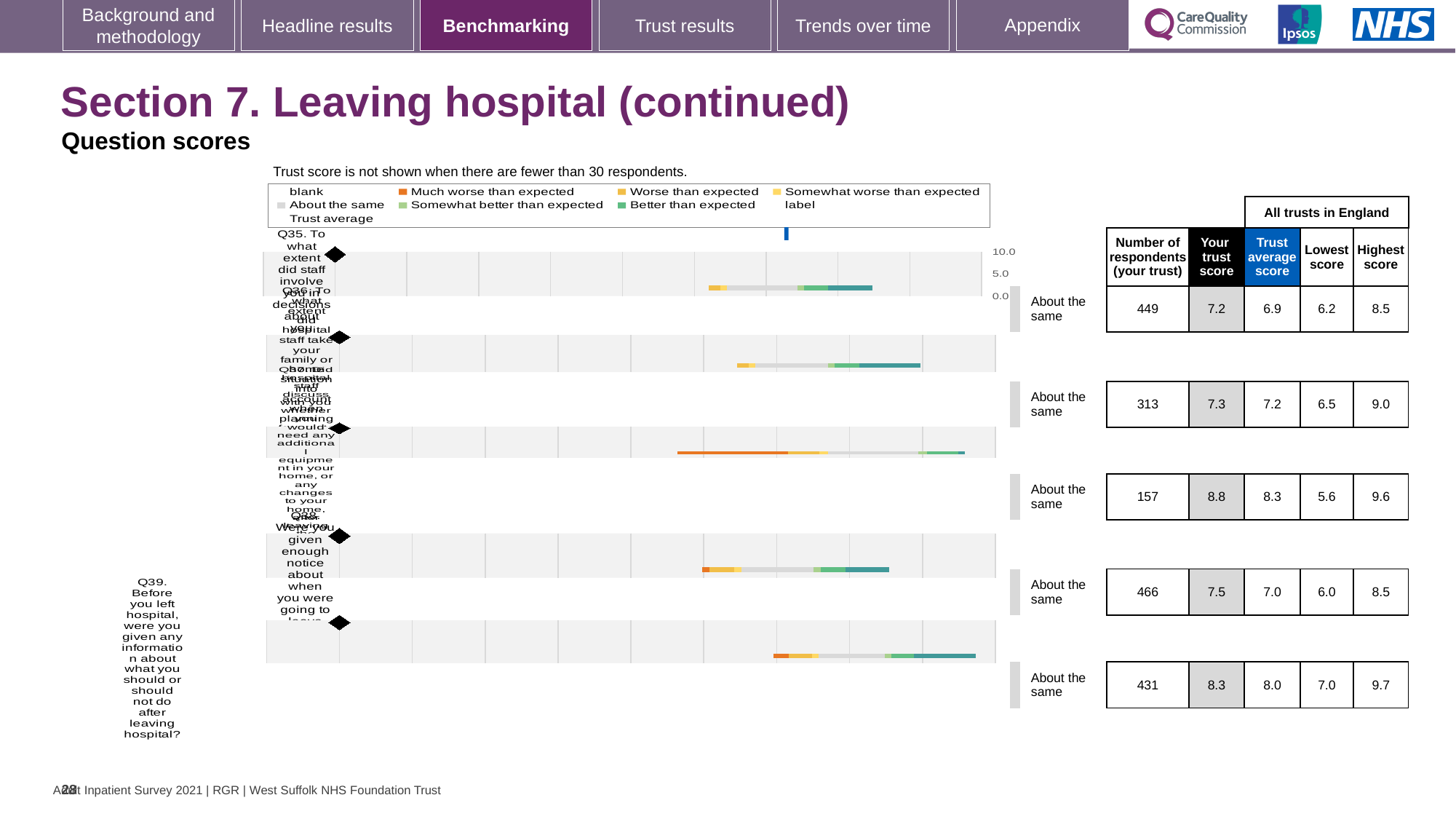
What is the 'Your trust score' in the first row of the table (Q35)? 7.2 What is the 'Your trust score' for Q39 (Before you left hospital, were you given any information about what you should or should not do after leaving hospital?)? 8.3 How many question rows are shown in the benchmarking chart? 5 What is the difference between your trust score and the trust average score for Q39? 0.3 How many respondents from your trust are shown in the first row of the table (Q35)? 449 What is the highest score across all trusts in England for Q39? 9.7 Which row of the table has the highest 'Your trust score'? The third row (8.8) What benchmark category is shown for every question on this slide? About the same Which row of the table has the lowest number of respondents? The third row (157) What is the trust average score for Q39? 8.0 Is your trust score for Q39 higher or lower than the trust average score? Higher How many respondents from your trust answered Q39? 431